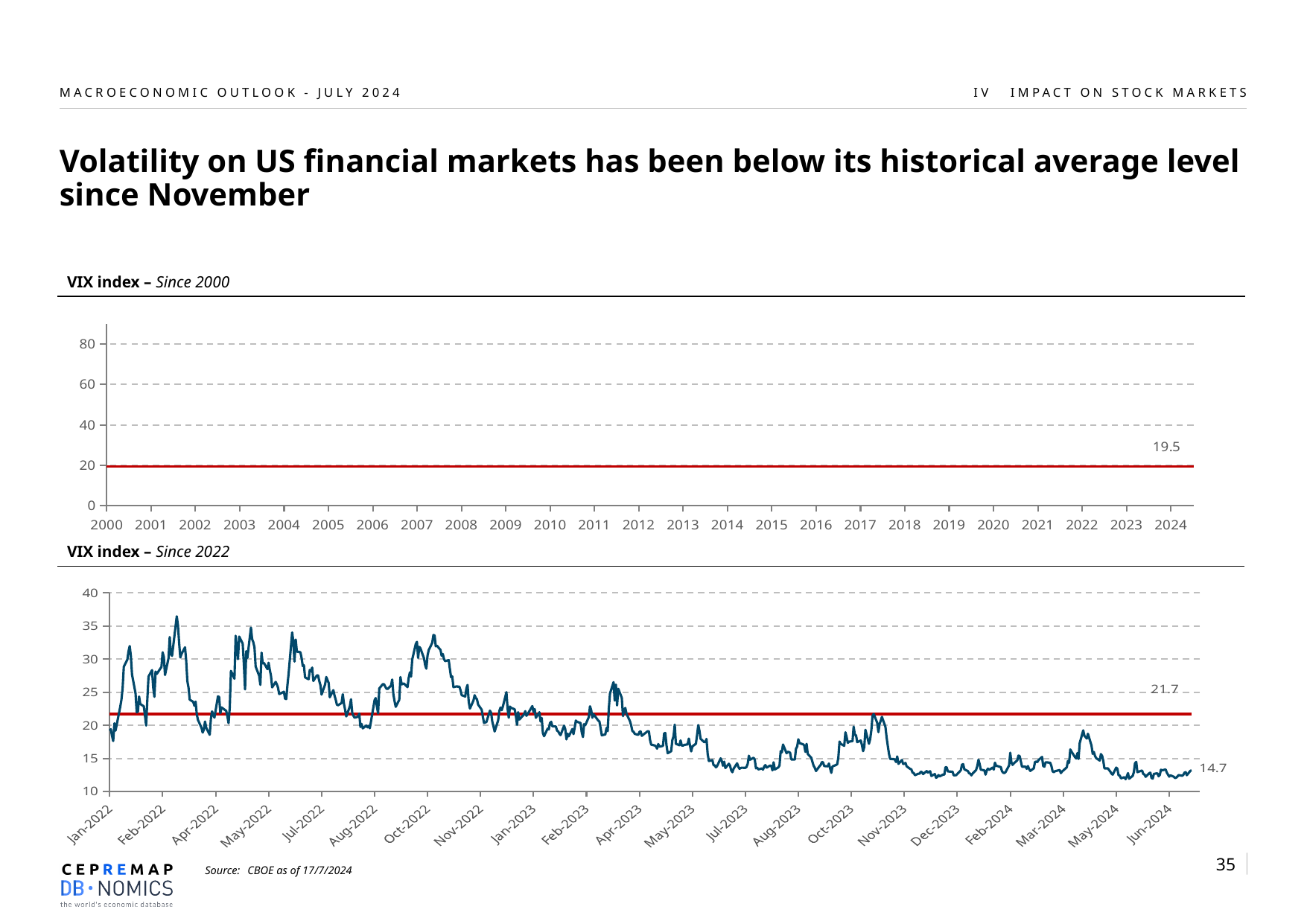
How many year labels are shown on the x axis of the 'VIX index – Since 2000' chart? 25 What is the difference between the red line value in the 'Since 2022' chart (21.7) and the red line value in the 'Since 2000' chart (19.5)? 2.2 In the 'VIX index – Since 2022' chart, is the value in Jul-2023 greater or less than 20? less What kind of chart is the 'VIX index – Since 2022' chart? line chart In the 'VIX index – Since 2022' chart, which is larger: the value in Feb-2022 or the value in Jun-2024? Feb-2022 In the 'VIX index – Since 2022' chart, what is the value labelled at the end of the line in Jun-2024? 14.7 In the 'VIX index – Since 2022' chart, does the VIX index generally rise or fall from Jan-2022 to Jun-2024? fall In the 'VIX index – Since 2022' chart, is the peak value in Feb-2022 greater or less than 30? greater What is the source cited for the charts on the slide? CBOE as of 17/7/2024 In the 'VIX index – Since 2022' chart, what value is labelled on the red horizontal line? 21.7 In the 'VIX index – Since 2000' chart, what value is labelled on the red horizontal line? 19.5 In the 'VIX index – Since 2022' chart, what is the difference between the red line value (21.7) and the final labelled value (14.7)? 7.0